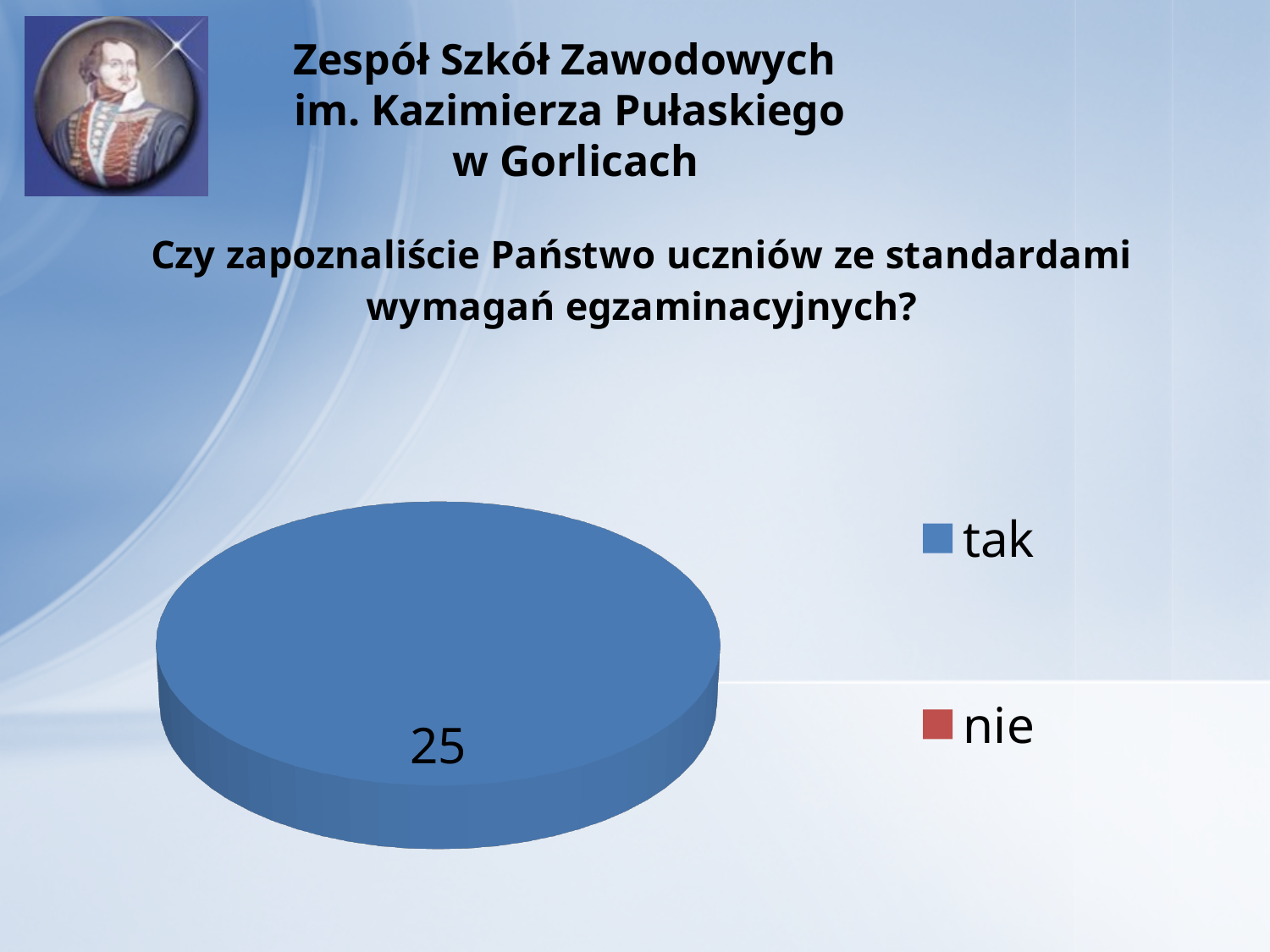
What colour represents "tak" in the pie chart legend? blue What kind of chart is shown on the slide? pie chart Which category has the largest slice in the pie chart? tak Which category has the smallest share of the pie chart? nie How many categories does the legend of the pie chart list? 2 What value is shown for the "tak" slice of the pie chart? 25 What colour represents "nie" in the pie chart legend? red Which is larger in the pie chart, "tak" or "nie"? tak